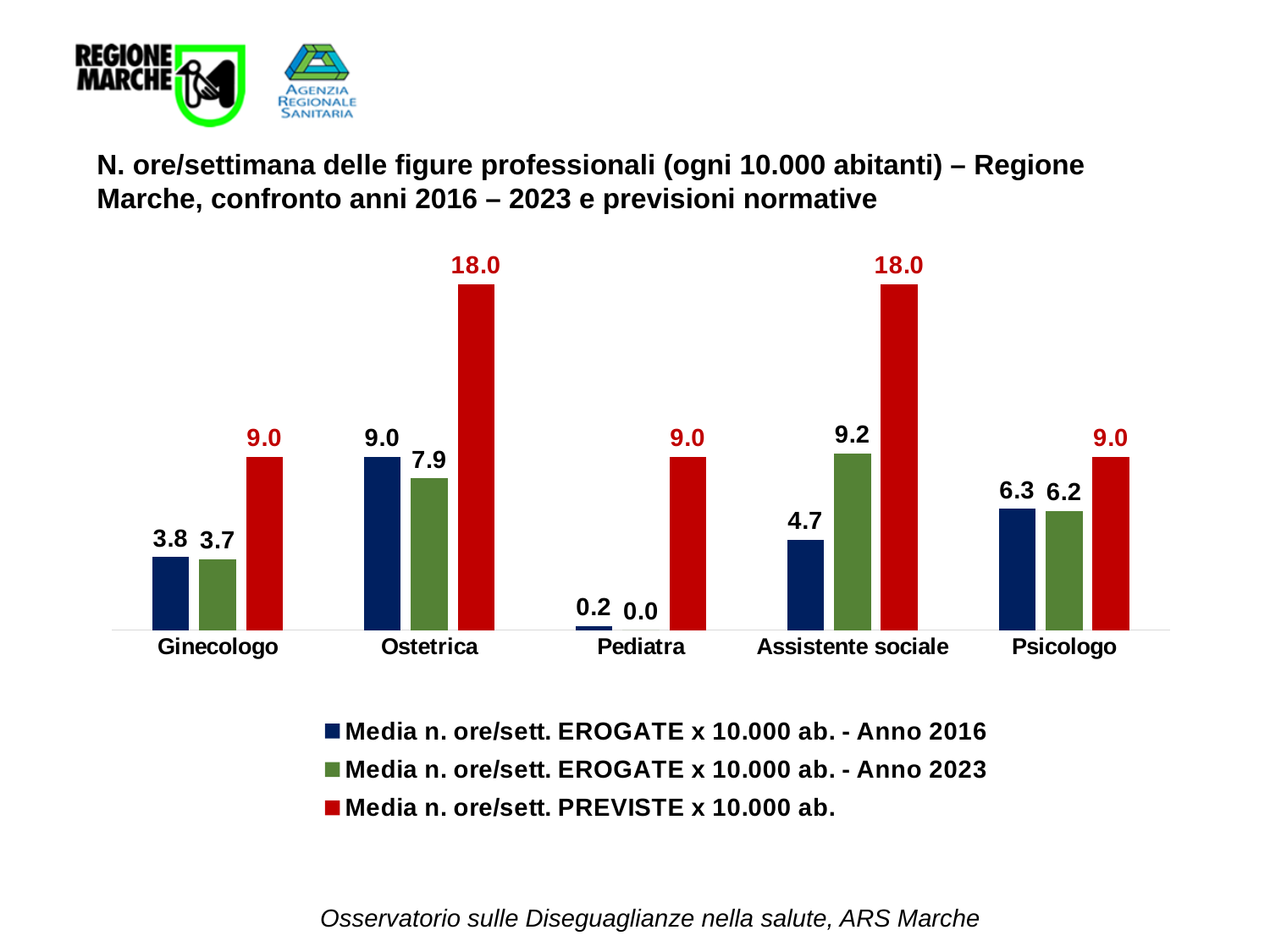
What colour are the bars for the 'Media n. ore/sett. PREVISTE x 10.000 ab.' series? Red For Assistente sociale, which is larger: the Anno 2016 value or the Anno 2023 value? Anno 2023 What is the 'Media n. ore/sett. PREVISTE x 10.000 ab.' value for Psicologo? 9.0 What is the difference between the PREVISTE value and the Anno 2023 value for Ostetrica? 10.1 How many series does the legend list? 3 Which category has the lowest value in the 'Media n. ore/sett. EROGATE x 10.000 ab. - Anno 2016' series? Pediatra What is the value for Ostetrica in the 'Media n. ore/sett. EROGATE x 10.000 ab. - Anno 2016' series? 9.0 What is the value for Assistente sociale in the 'Media n. ore/sett. EROGATE x 10.000 ab. - Anno 2023' series? 9.2 What kind of chart is shown on the slide? Bar chart How many professional categories are shown on the x axis? 5 What is the value for Pediatra in the 'Media n. ore/sett. EROGATE x 10.000 ab. - Anno 2023' series? 0.0 Which category has the highest value in the 'Media n. ore/sett. EROGATE x 10.000 ab. - Anno 2023' series? Assistente sociale